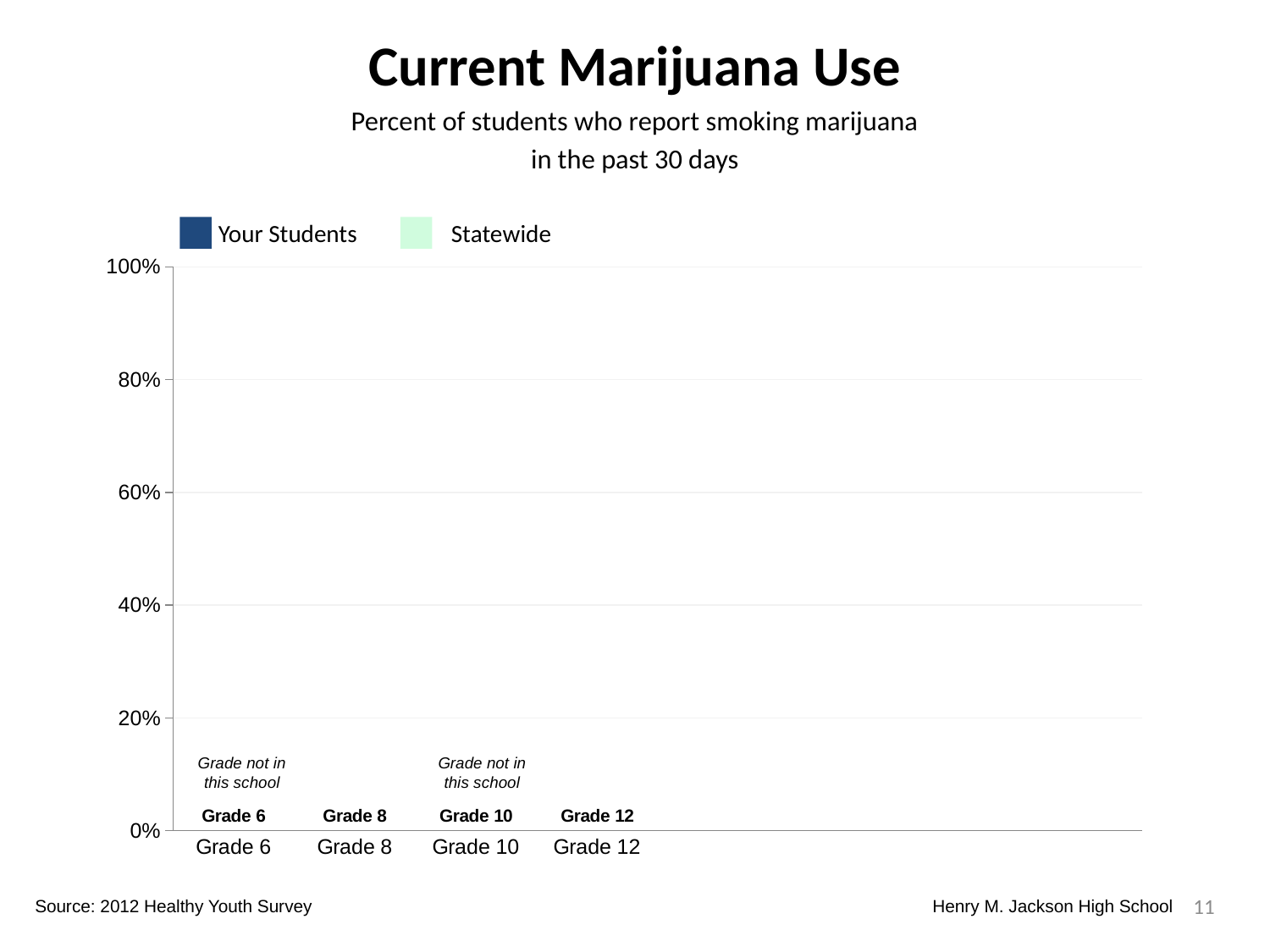
What is the highest value shown on the y axis? 100% How many series does the legend list? 2 What is the title of the chart? Current Marijuana Use What are the two series named in the legend? Your Students and Statewide Which grades are marked as 'Grade not in this school'? Grade 6 and Grade 10 How many grade categories are shown on the x axis? 4